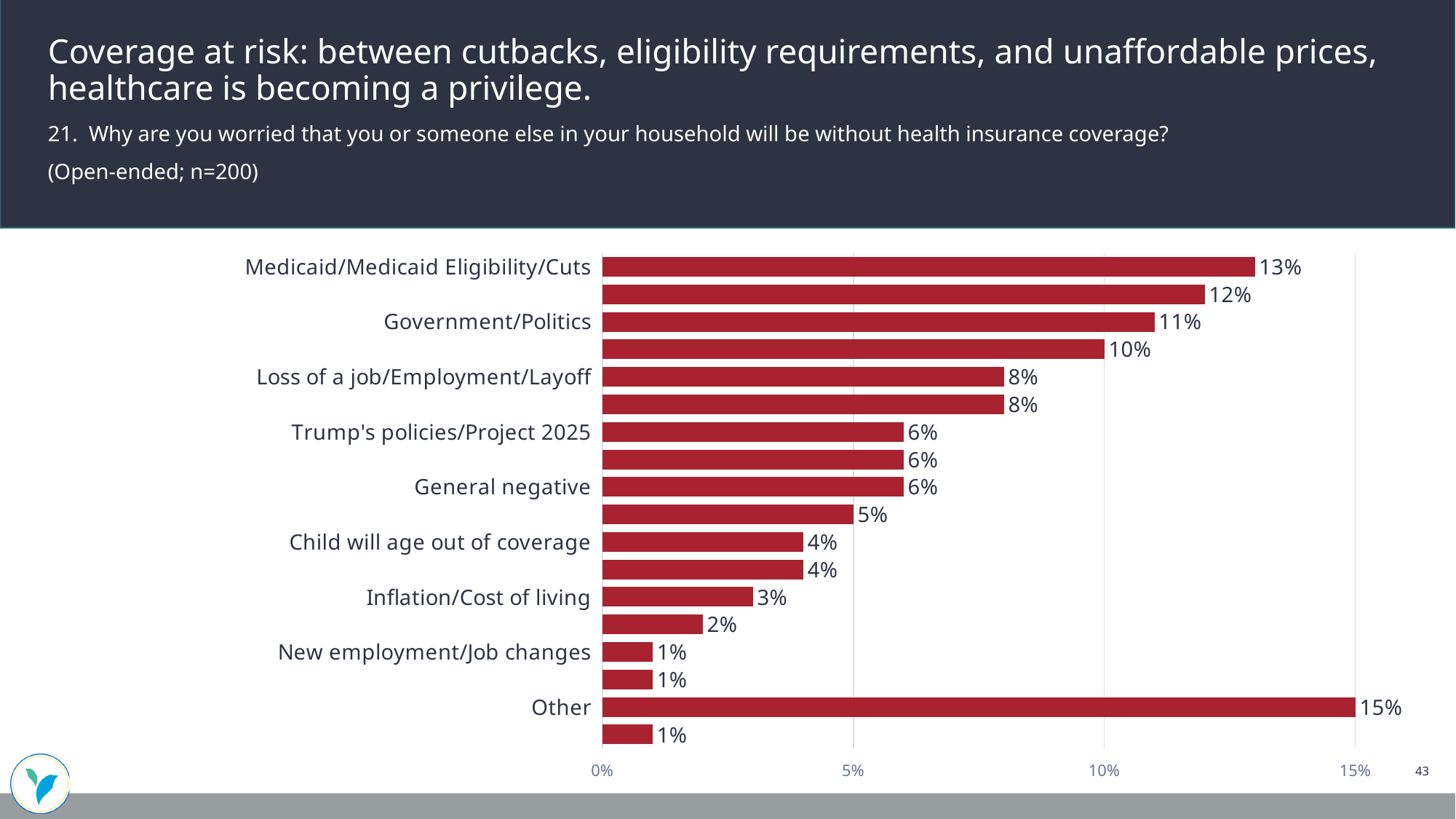
What is the value for Government/Politics? 11% What is the value for Medicaid/Medicaid Eligibility/Cuts? 13% Is the value for Trump's policies/Project 2025 greater or less than 10%? less What is the value for Loss of a job/Employment/Layoff? 8% Which labelled category has the highest value? Other What kind of chart is shown on the slide? bar chart What is the value for Inflation/Cost of living? 3% What is the value for Child will age out of coverage? 4% What is the difference between the values for Medicaid/Medicaid Eligibility/Cuts and Government/Politics? 2 percentage points What is the value for Other? 15% Which is larger, the value for Other or the value for Medicaid/Medicaid Eligibility/Cuts? Other How many bars are plotted in the chart? 18